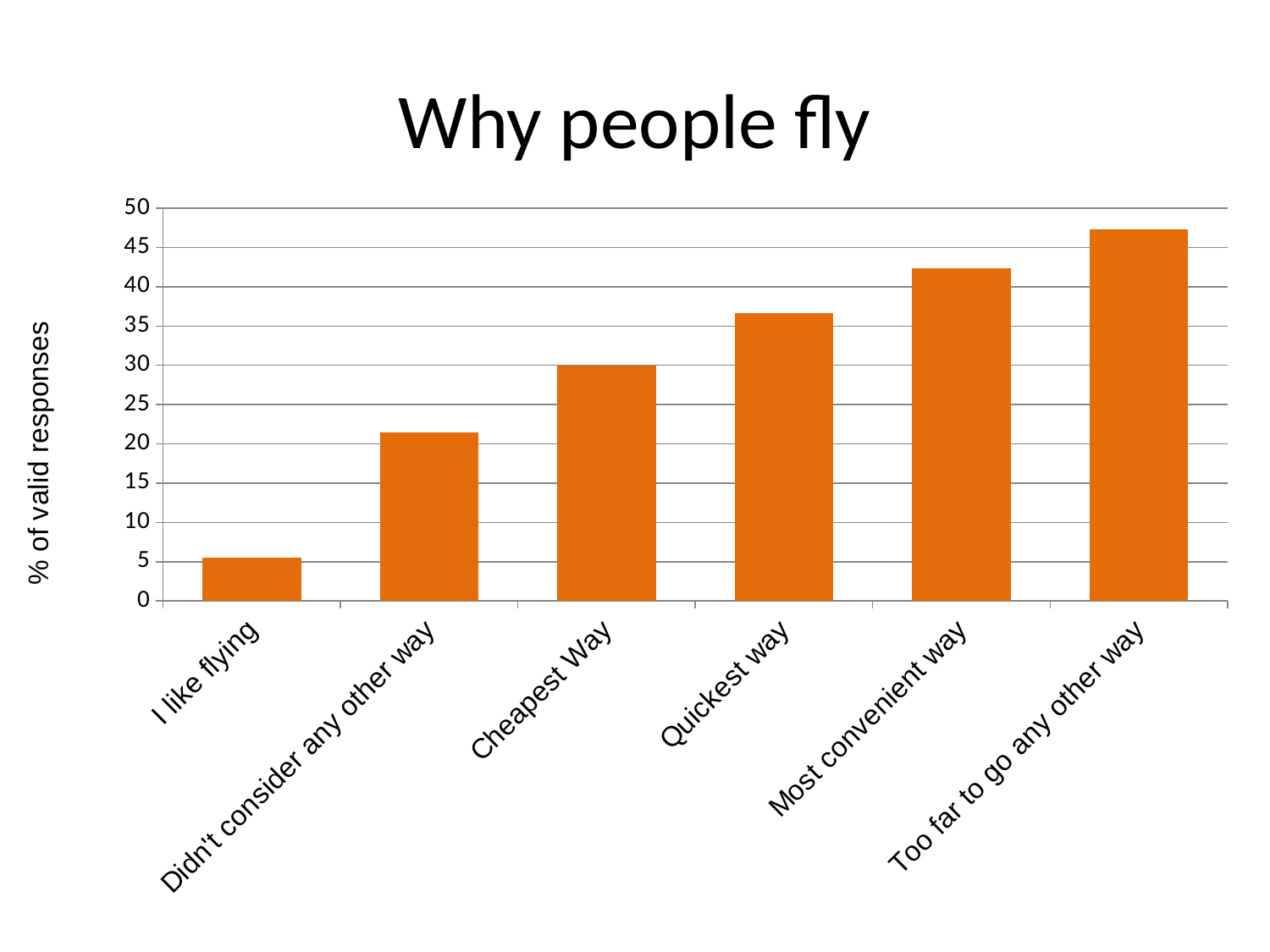
Which is larger, the value for Cheapest Way or the value for Quickest way? Quickest way How many categories are plotted in the chart? 6 What is the label of the vertical axis? % of valid responses Is the value for I like flying greater or less than 10? less Which category has the lowest value? I like flying Do the values rise or fall moving from left to right along the x axis? rise Is the value for Most convenient way greater or less than 40? greater Which category has the highest value? Too far to go any other way What kind of chart is shown on the slide? bar chart What is the title of the chart? Why people fly Is the value for Didn't consider any other way greater or less than 25? less